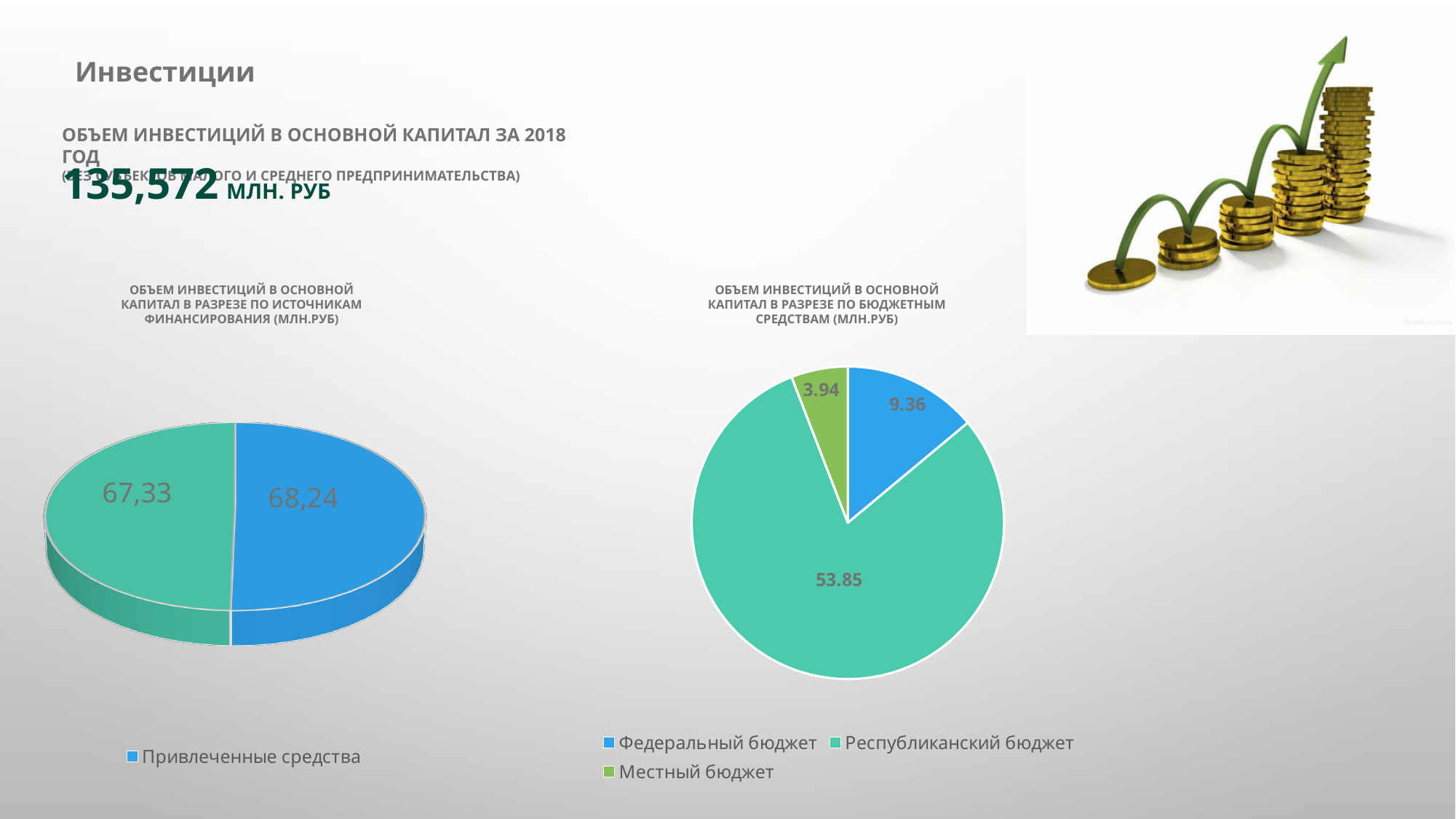
In the right chart (по бюджетным средствам), how many slices does the pie have? 3 In the right chart (по бюджетным средствам), what is the value for Республиканский бюджет? 53.85 In the right chart (по бюджетным средствам), what is the value for Федеральный бюджет? 9.36 In the right chart (по бюджетным средствам), what is the difference between Республиканский бюджет and Федеральный бюджет? 44.49 In the right chart (по бюджетным средствам), which budget source has the largest slice? Республиканский бюджет In the right chart (по бюджетным средствам), which budget source has the smallest slice? Местный бюджет In the left chart (по источникам финансирования), what is the value for Привлеченные средства? 68,24 What kind of chart is the left chart (по источникам финансирования)? Pie chart In the right chart (по бюджетным средствам), what is the difference between Федеральный бюджет and Местный бюджет? 5.42 In the right chart (по бюджетным средствам), what is the value for Местный бюджет? 3.94 In the left chart (по источникам финансирования), how many slices does the pie have? 2 In the right chart (по бюджетным средствам), how many entries does the legend list? 3